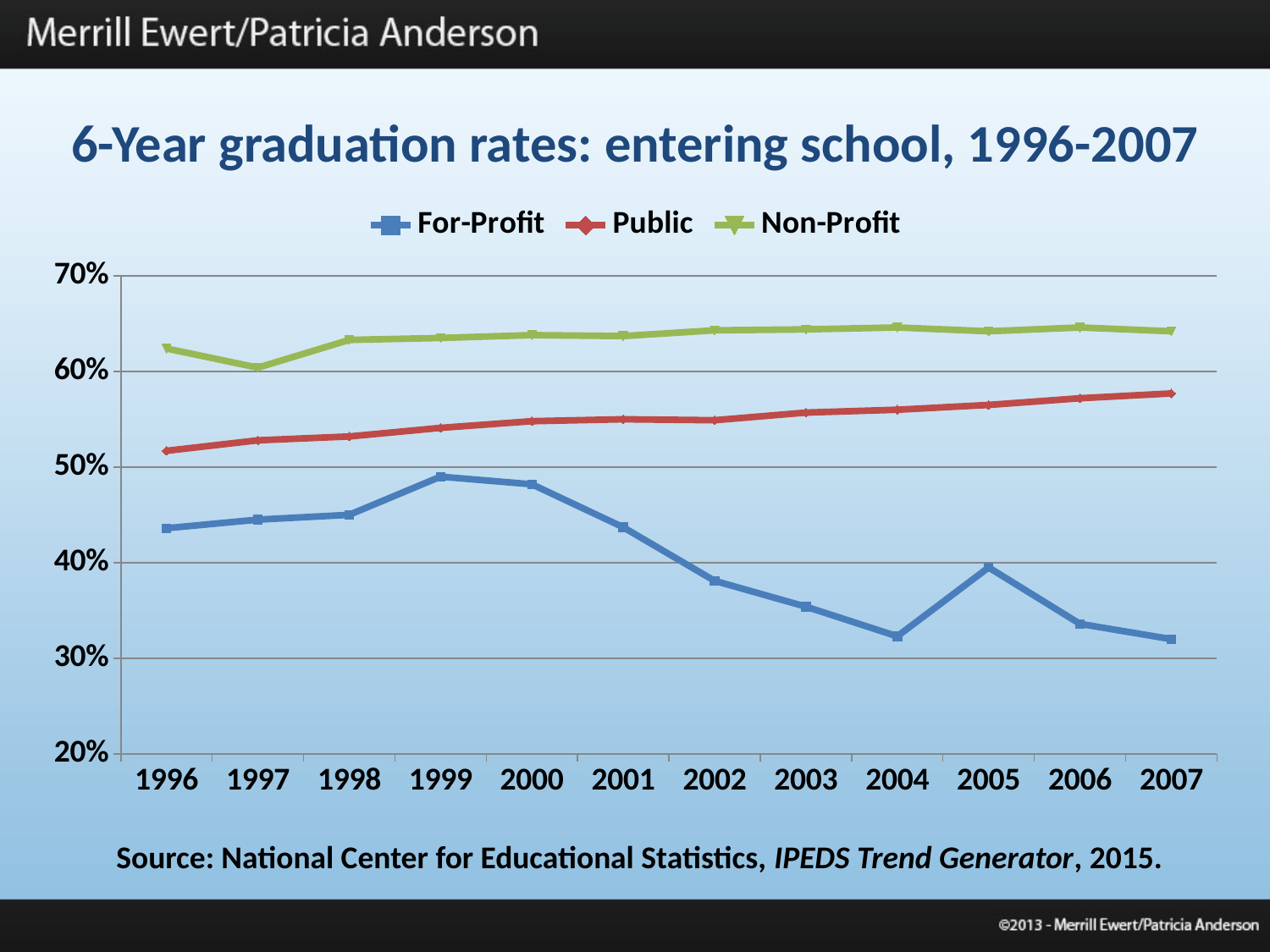
How many series does the legend list? 3 Is the For-Profit value for 1999 greater or less than 40%? greater In 2007, which is larger: the Public rate or the For-Profit rate? Public What kind of chart is shown on the slide? Line chart How many years are plotted along the x axis? 12 Does the Public line generally rise or fall from 1996 to 2007? Rise In which year is the Non-Profit line at its lowest? 1997 In which year does the Public line reach its highest value? 2007 In which year does the For-Profit line reach its highest value? 1999 Which series is shown in green in the legend? Non-Profit Is the For-Profit value for 2004 greater or less than 40%? less Is the Non-Profit value for 1996 greater or less than 60%? greater